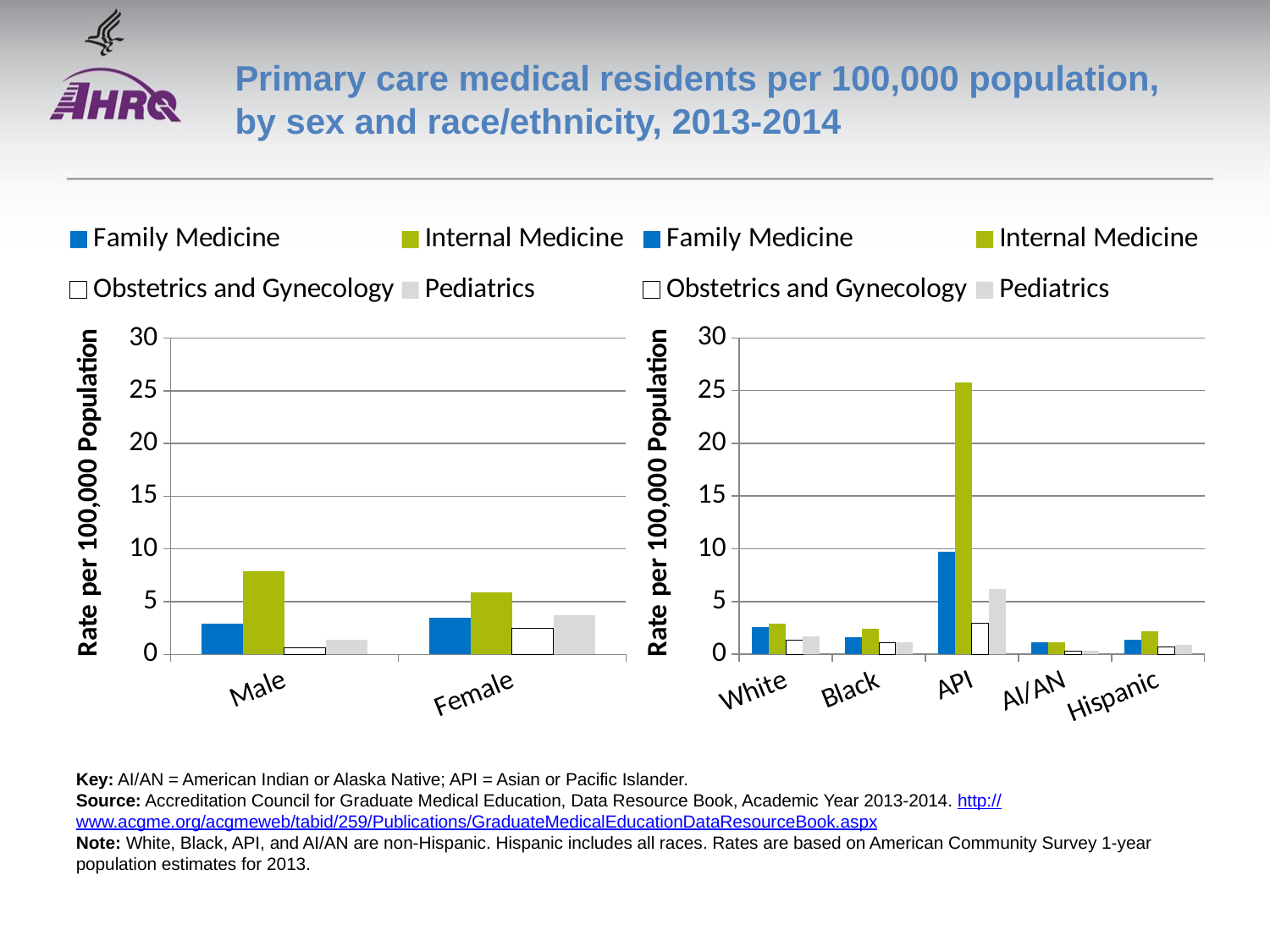
What kind of chart is the left chart, showing rates by sex? Bar chart In the left chart (by sex), which has the larger Internal Medicine rate, Male or Female? Male In the right chart (by race/ethnicity), is the Internal Medicine value for API greater or less than 20? greater How many categories are shown on the x axis of the right chart (by race/ethnicity)? 5 What is the y-axis title of the left chart (by sex)? Rate per 100,000 Population How many series does the legend of the right chart (by race/ethnicity) list? 4 In the left chart (by sex), is the Internal Medicine value for Male greater or less than 5? greater In the left chart (by sex), which has the larger Pediatrics rate, Male or Female? Female In the right chart (by race/ethnicity), is the Family Medicine value for API greater or less than 5? greater How many categories are shown on the x axis of the left chart (by sex)? 2 In the right chart (by race/ethnicity), which series has the highest value for API? Internal Medicine In the right chart (by race/ethnicity), which category has the highest Internal Medicine rate? API